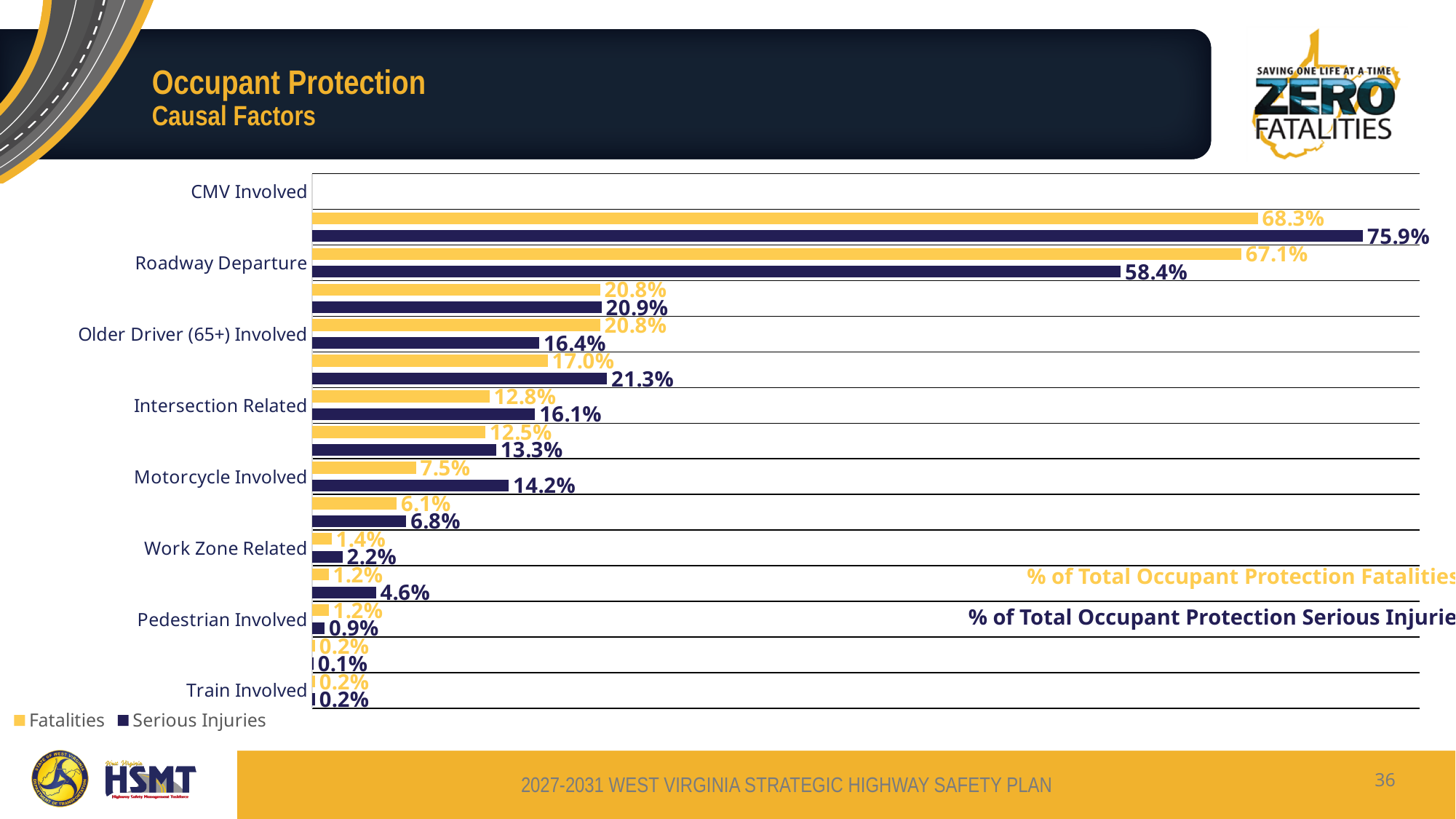
What is the lowest value shown for the Serious Injuries series? 0.1% What are the two series named in the chart legend? Fatalities and Serious Injuries What is the highest value shown for the Serious Injuries series? 75.9% What is the second-highest value shown for the Serious Injuries series? 58.4% What is the second-highest value shown for the Fatalities series? 67.1% How many series does the chart legend list? 2 What is the difference between the largest Serious Injuries value (75.9%) and the largest Fatalities value (68.3%)? 7.6 percentage points Which colour represents the Fatalities series in the chart? yellow Is the highest Serious Injuries value greater or less than 70%? greater Which is larger: the longest Fatalities bar or the longest Serious Injuries bar? the longest Serious Injuries bar What kind of chart is shown on the slide? bar chart What is the highest value shown for the Fatalities series? 68.3%